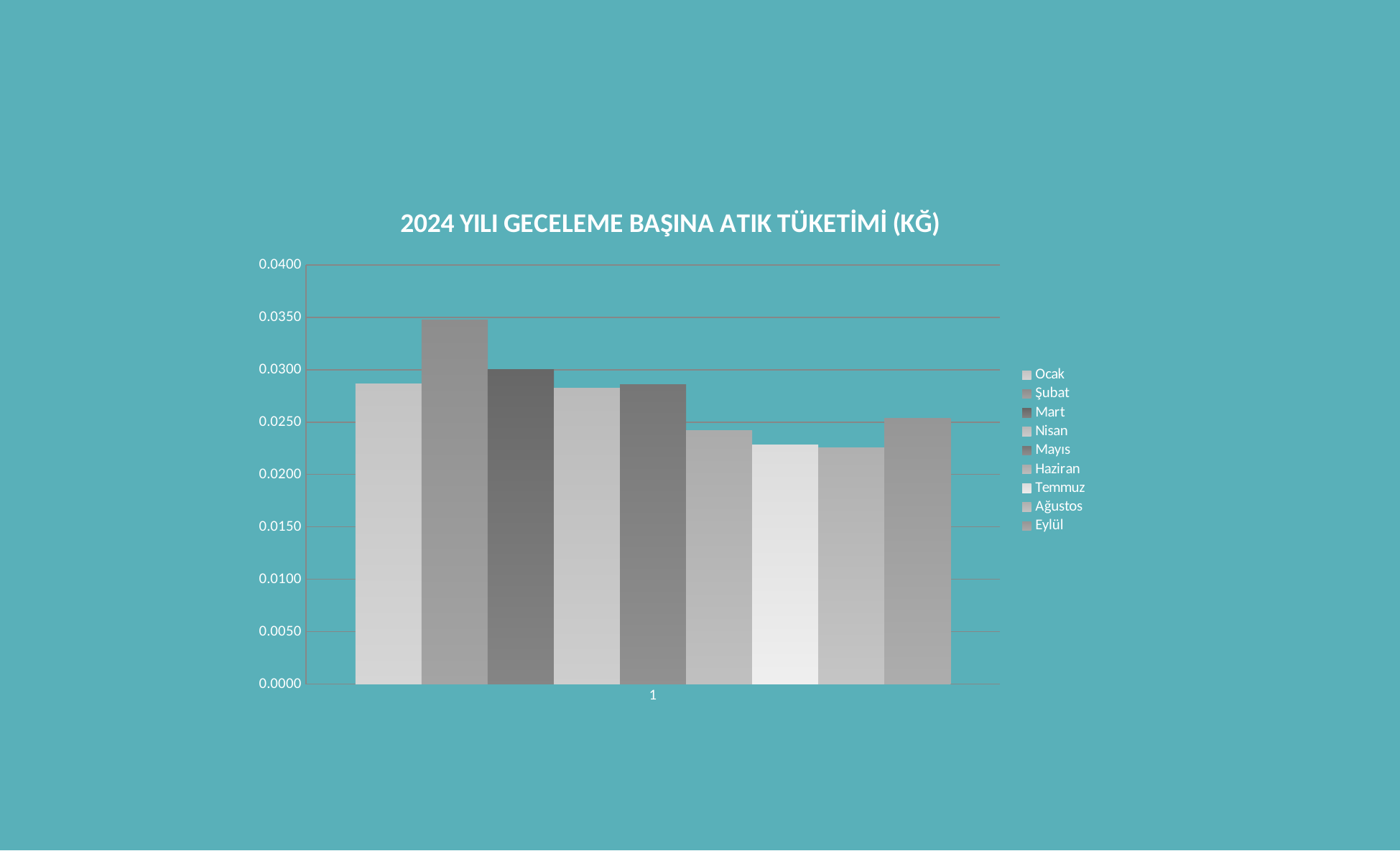
Is the value for Temmuz greater or less than 0.0250? less Is the value for Şubat greater or less than 0.0300? greater Which month is listed first in the legend? Ocak Is the value for Haziran greater or less than 0.0250? less Which is larger, the value for Ocak or the value for Haziran? Ocak How many series does the legend list? 9 What kind of chart is shown on the slide? bar chart Which month has the highest value? Şubat What is the title of the chart? 2024 YILI GECELEME BAŞINA ATIK TÜKETİMİ (KĞ) Which is larger, the value for Şubat or the value for Ocak? Şubat